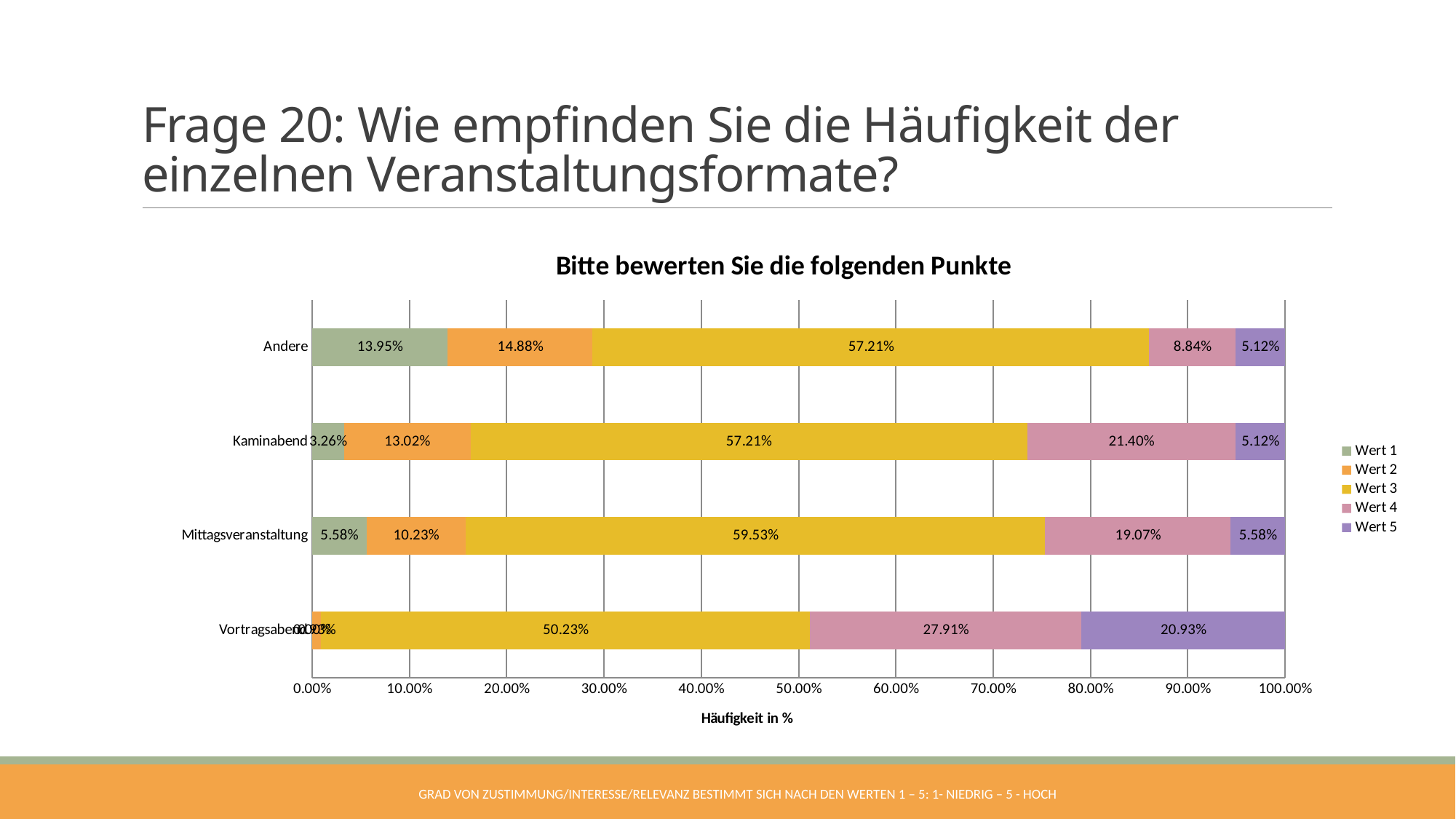
Which category has the lowest Wert 4 value? Andere Which category has the highest Wert 3 value? Mittagsveranstaltung What is the difference between the Wert 4 values for Vortragsabend and Mittagsveranstaltung? 8.84% How many categories are shown on the vertical axis? 4 What type of chart is shown on the slide? stacked bar chart What is the Wert 4 value for Kaminabend? 21.40% Which is larger, the Wert 2 value for Andere or the Wert 2 value for Kaminabend? Andere How many series does the legend list? 5 What is the Wert 1 value for Mittagsveranstaltung? 5.58% What is the title of the chart? Bitte bewerten Sie die folgenden Punkte What is the Wert 5 value for Vortragsabend? 20.93% What is the Wert 3 value for Andere? 57.21%